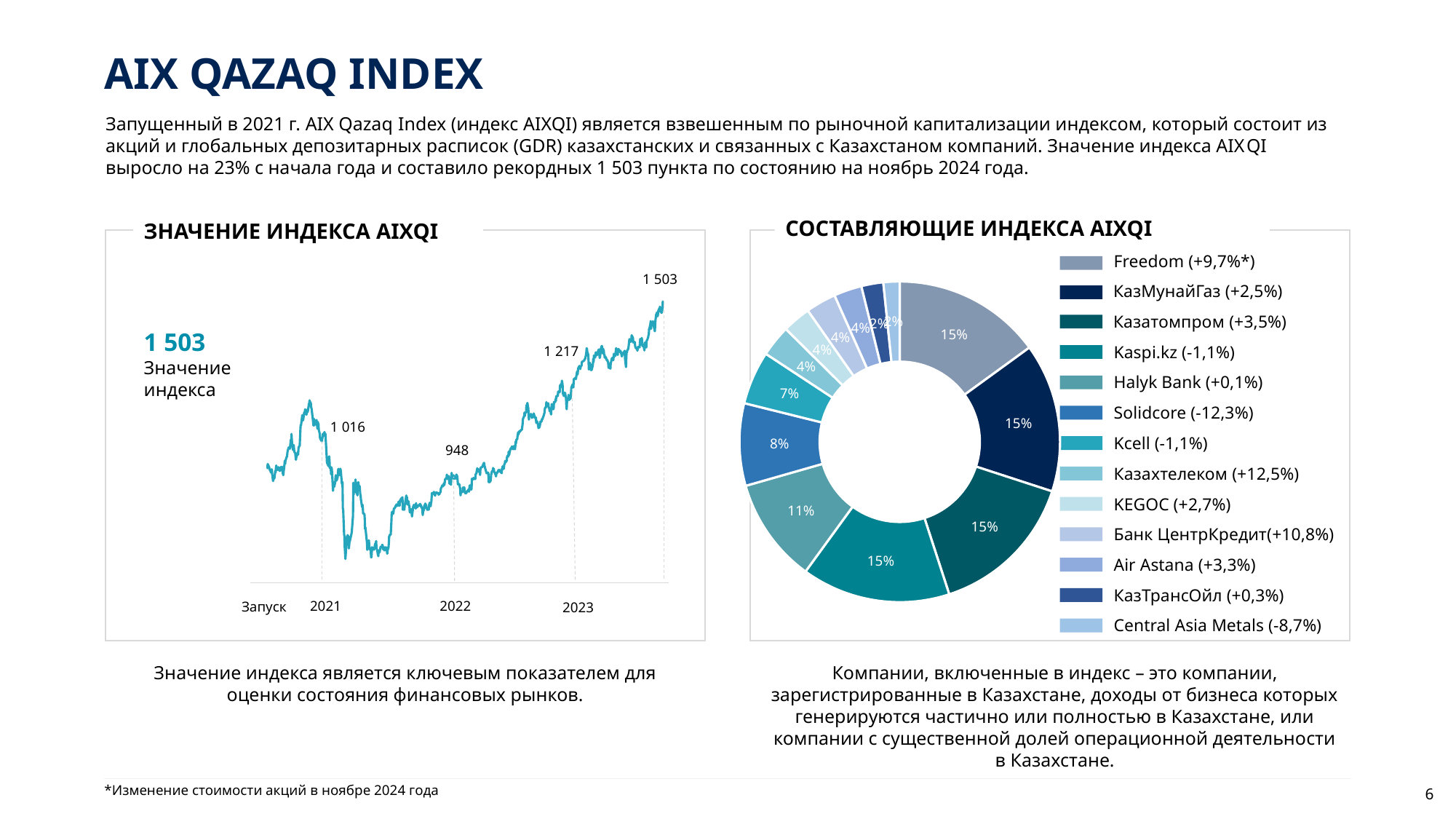
In the 'ЗНАЧЕНИЕ ИНДЕКСА AIXQI' chart, what value is labelled at the 2023 mark? 1 217 In the 'ЗНАЧЕНИЕ ИНДЕКСА AIXQI' chart, which of the labelled values is the lowest? 948 In the 'СОСТАВЛЯЮЩИЕ ИНДЕКСА AIXQI' chart, what share of the index does Solidcore hold? 8% What kind of chart is the 'ЗНАЧЕНИЕ ИНДЕКСА AIXQI' chart on the left? line chart In the 'ЗНАЧЕНИЕ ИНДЕКСА AIXQI' chart, what value is labelled at the 2022 mark? 948 In the 'СОСТАВЛЯЮЩИЕ ИНДЕКСА AIXQI' chart, which company's legend entry shows a change of -12,3%? Solidcore What kind of chart is the 'СОСТАВЛЯЮЩИЕ ИНДЕКСА AIXQI' chart on the right? pie chart In the 'ЗНАЧЕНИЕ ИНДЕКСА AIXQI' chart, what is the last labelled value of the index at the end of the line? 1 503 In the 'ЗНАЧЕНИЕ ИНДЕКСА AIXQI' chart, does the index rise or fall between the 2022 mark and the end of the line? rise In the 'ЗНАЧЕНИЕ ИНДЕКСА AIXQI' chart, what is the difference between the final value 1 503 and the 2023 value 1 217? 286 How many companies does the legend of the 'СОСТАВЛЯЮЩИЕ ИНДЕКСА AIXQI' chart list? 13 In the 'СОСТАВЛЯЮЩИЕ ИНДЕКСА AIXQI' chart, what share of the index does Halyk Bank hold? 11%